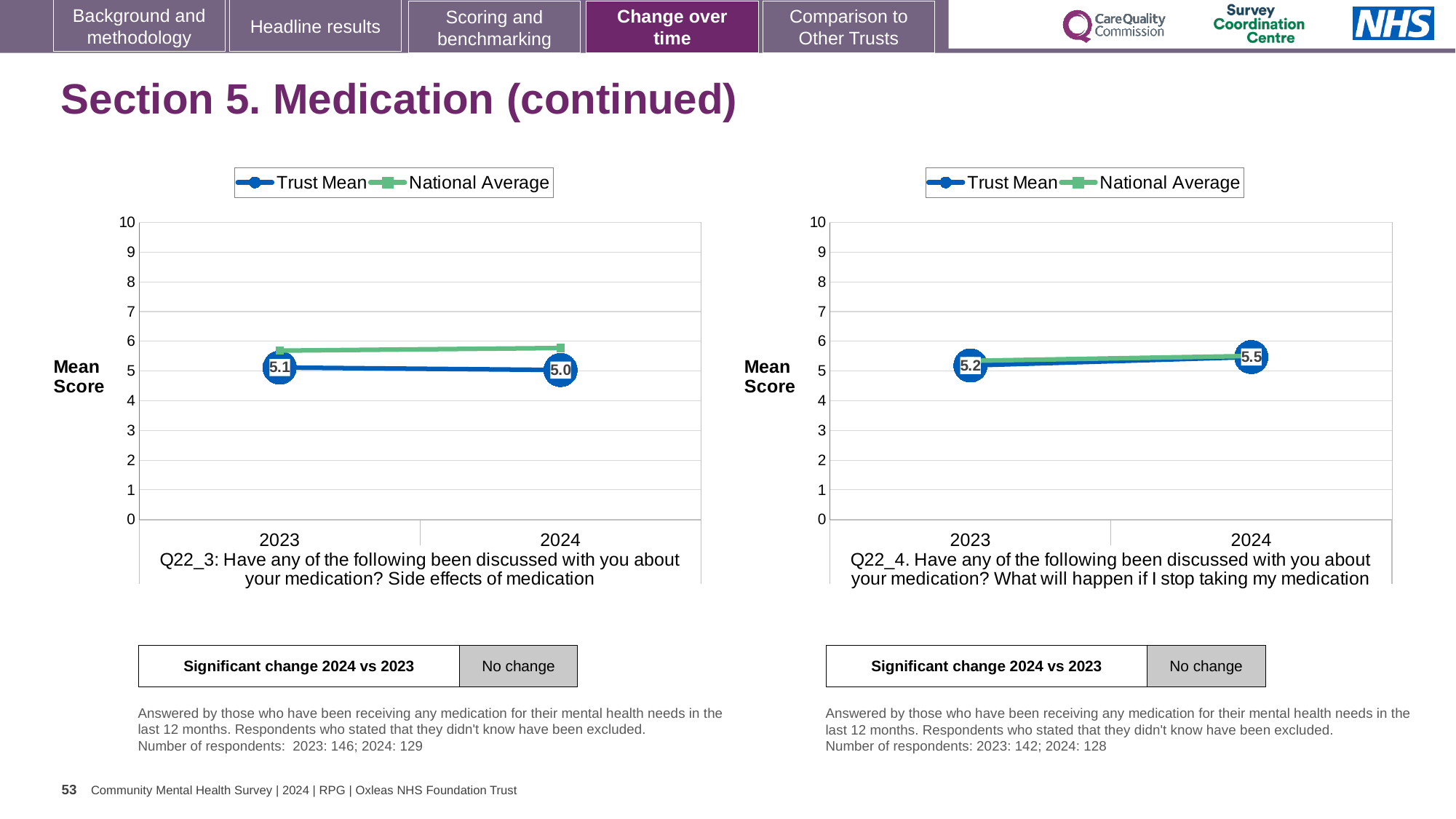
In the right chart (Q22_4), by how much did the Trust Mean change from 2023 to 2024? 0.3 How many years are shown on the x axis of the right chart (Q22_4)? 2 In the left chart (Q22_3), what is the Trust Mean for 2024? 5.0 How many series does the legend of the left chart list? 2 What is the maximum value shown on the y axis of the left chart? 10 In the right chart (Q22_4), what is the Trust Mean for 2023? 5.2 In the left chart (Q22_3), which year has the higher Trust Mean, 2023 or 2024? 2023 In the right chart (Q22_4), does the Trust Mean rise or fall from 2023 to 2024? rise In the right chart (Q22_4), what is the Trust Mean for 2024? 5.5 What type of chart is used on this slide? line chart In the left chart (Q22_3), what is the Trust Mean for 2023? 5.1 In the left chart (Q22_3), is the National Average for 2023 greater or less than 5? greater